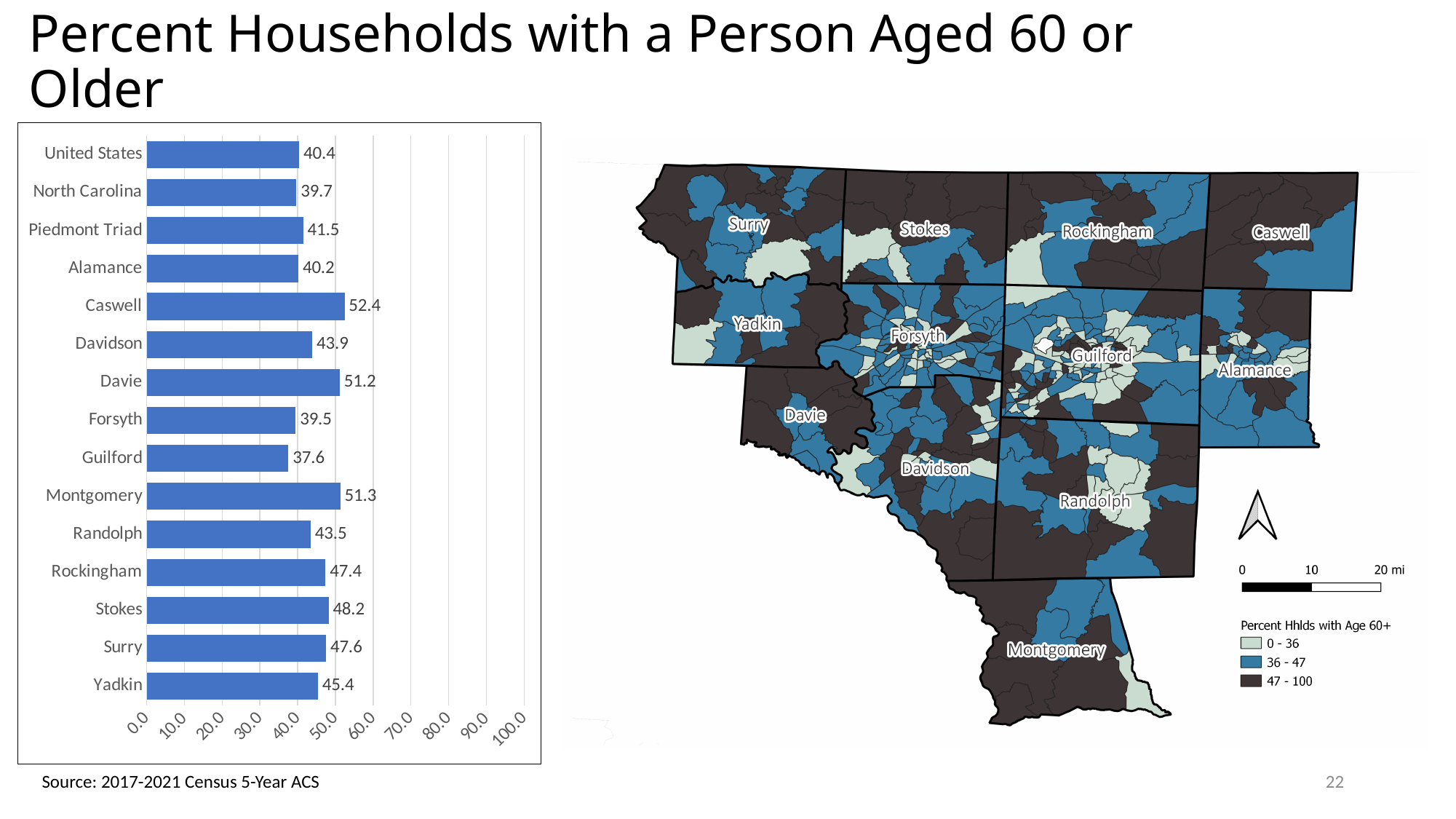
Which category has the highest value in the bar chart? Caswell What is the value for Caswell in the bar chart? 52.4 What is the value for Guilford in the bar chart? 37.6 What is the title of the slide containing the bar chart? Percent Households with a Person Aged 60 or Older In the bar chart, which is larger, the value for Rockingham or the value for Randolph? Rockingham Which category has the lowest value in the bar chart? Guilford How many categories are shown in the bar chart? 15 What is the difference between the values for Stokes and Surry in the bar chart? 0.6 What kind of chart is shown on the left of the slide? bar chart What is the difference between the values for Caswell and Guilford in the bar chart? 14.8 What is the value for North Carolina in the bar chart? 39.7 In the bar chart, is the value for Caswell greater or less than 50.0? greater